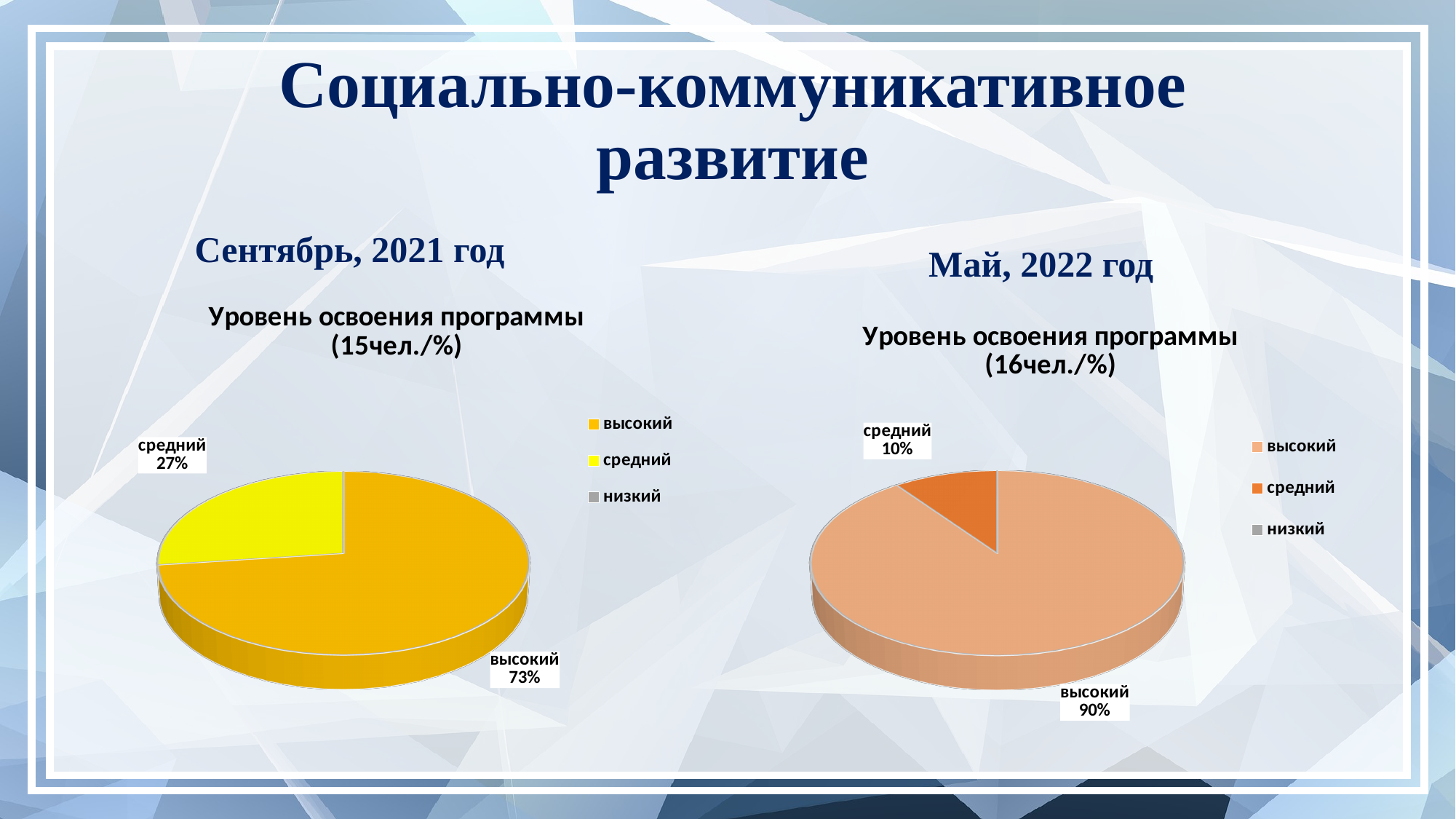
What type of chart is used on the left (Сентябрь, 2021 год)? pie chart How many slices with data labels are visible in the right chart (Май, 2022 год)? 2 In the left chart (Сентябрь, 2021 год), what is the difference between the высокий and средний shares? 46% In the right chart (Май, 2022 год), what is the share for средний? 10% In the left chart (Сентябрь, 2021 год), which category has the largest slice? высокий What is the title of the left chart (Сентябрь, 2021 год)? Уровень освоения программы (15чел./%) In the right chart (Май, 2022 год), which labelled category has the smallest slice? средний In the left chart (Сентябрь, 2021 год), what is the share for высокий? 73% How many entries does the legend of the right chart (Май, 2022 год) list? 3 In the right chart (Май, 2022 год), what is the share for высокий? 90% Which chart shows a larger share for высокий, the left (Сентябрь, 2021 год) or the right (Май, 2022 год)? the right (Май, 2022 год) In the left chart (Сентябрь, 2021 год), what is the share for средний? 27%